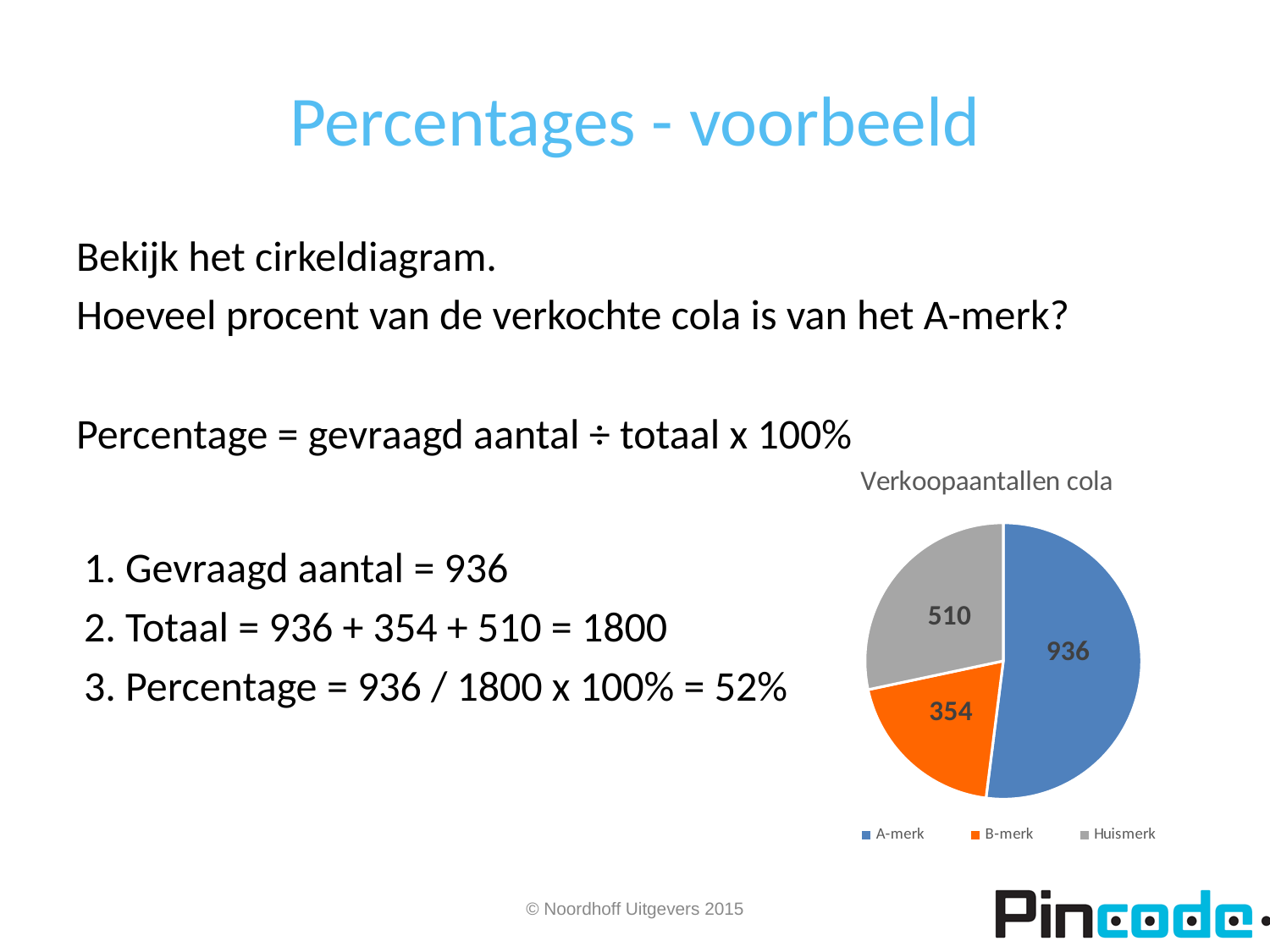
What is the difference between the values for Huismerk and B-merk? 156 What is the value for B-merk in the pie chart? 354 What is the value for Huismerk in the pie chart? 510 What is the title of the pie chart? Verkoopaantallen cola What share of the pie does A-merk represent? 52% Which category has the smallest slice in the pie chart? B-merk Which is larger, the value for Huismerk or the value for B-merk? Huismerk What is the difference between the values for A-merk and Huismerk? 426 What type of chart is shown on the slide? pie chart How many categories does the pie chart have? 3 What is the value for A-merk in the pie chart? 936 Which category has the largest slice in the pie chart? A-merk